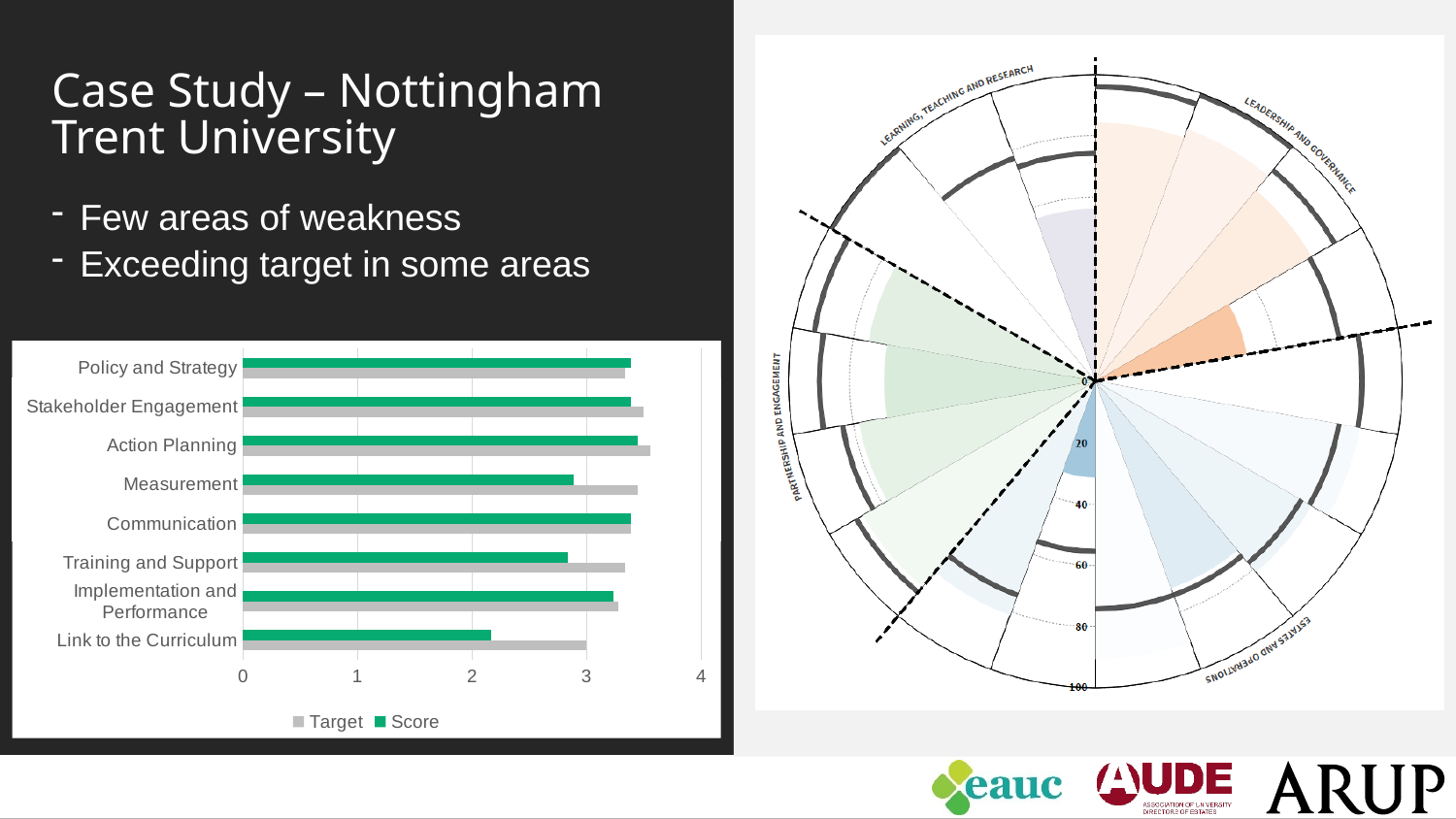
In the bar chart on the left, is the Score for Link to the Curriculum greater or less than 2? greater In the bar chart on the left, is the Target for Measurement greater or less than 3? greater In the bar chart on the left, is the Score for Measurement greater or less than 3? less What kind of chart is the chart on the left of the slide? bar chart In the bar chart on the left, what is the highest value shown on the horizontal axis? 4 In the bar chart on the left, which category has the lowest Target? Link to the Curriculum In the bar chart on the left, for Training and Support, which is larger: the Target or the Score? Target In the bar chart on the left, which series is shown in green? Score In the bar chart on the left, how many series does the legend list? 2 In the bar chart on the left, how many categories are listed on the vertical axis? 8 In the bar chart on the left, which category has the lowest Score? Link to the Curriculum